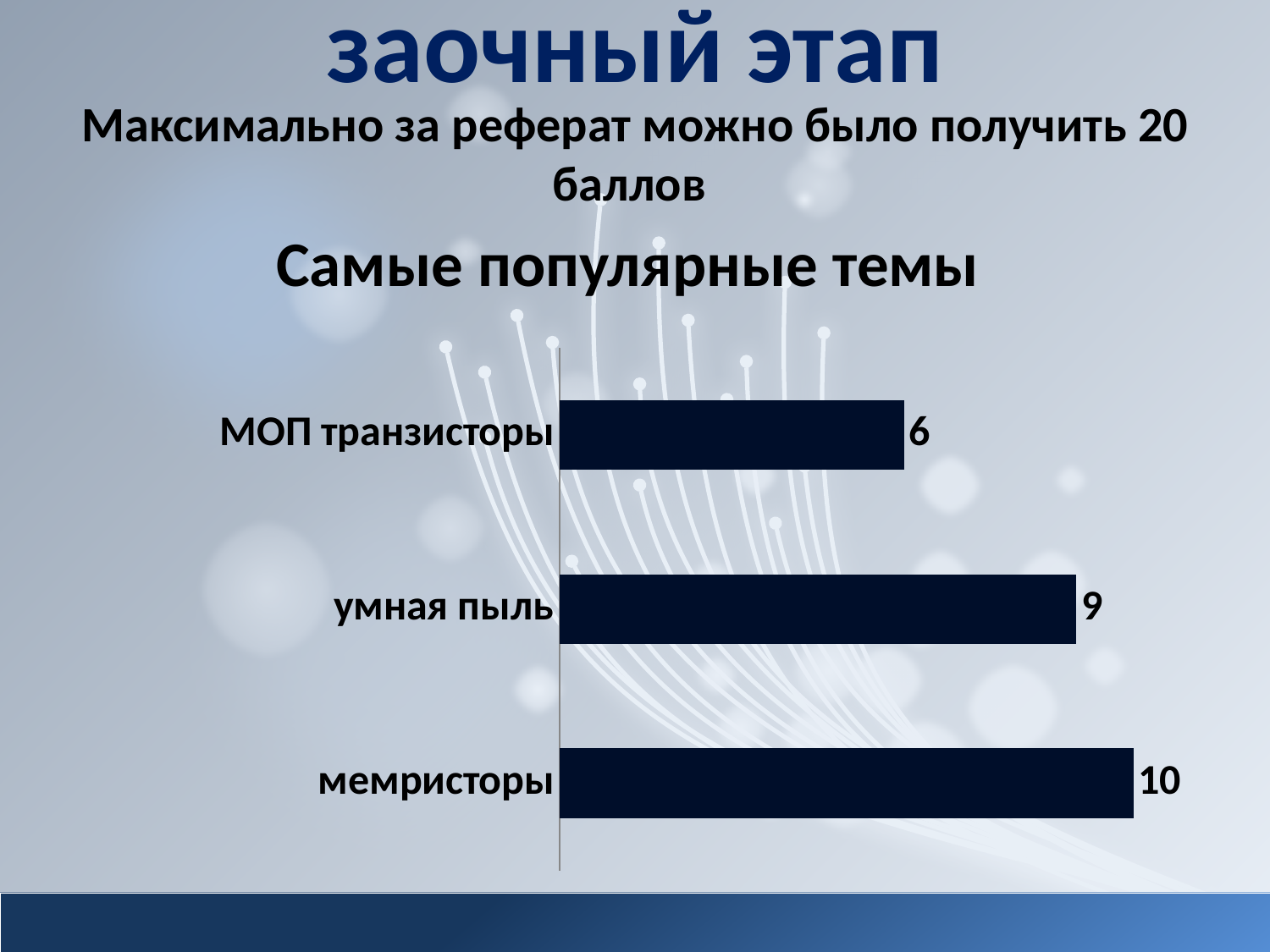
What is the difference between the values for умная пыль and МОП транзисторы? 3 What is the title of the chart? Самые популярные темы What is the value for мемристоры? 10 What kind of chart is shown on the slide? bar chart How many categories are shown in the chart? 3 What is the difference between the values for мемристоры and МОП транзисторы? 4 Which category has the highest value? мемристоры Which category has the lowest value? МОП транзисторы What is the total of the values for all three categories? 25 What is the value for МОП транзисторы? 6 Which is larger, the value for умная пыль or the value for МОП транзисторы? умная пыль What is the value for умная пыль? 9